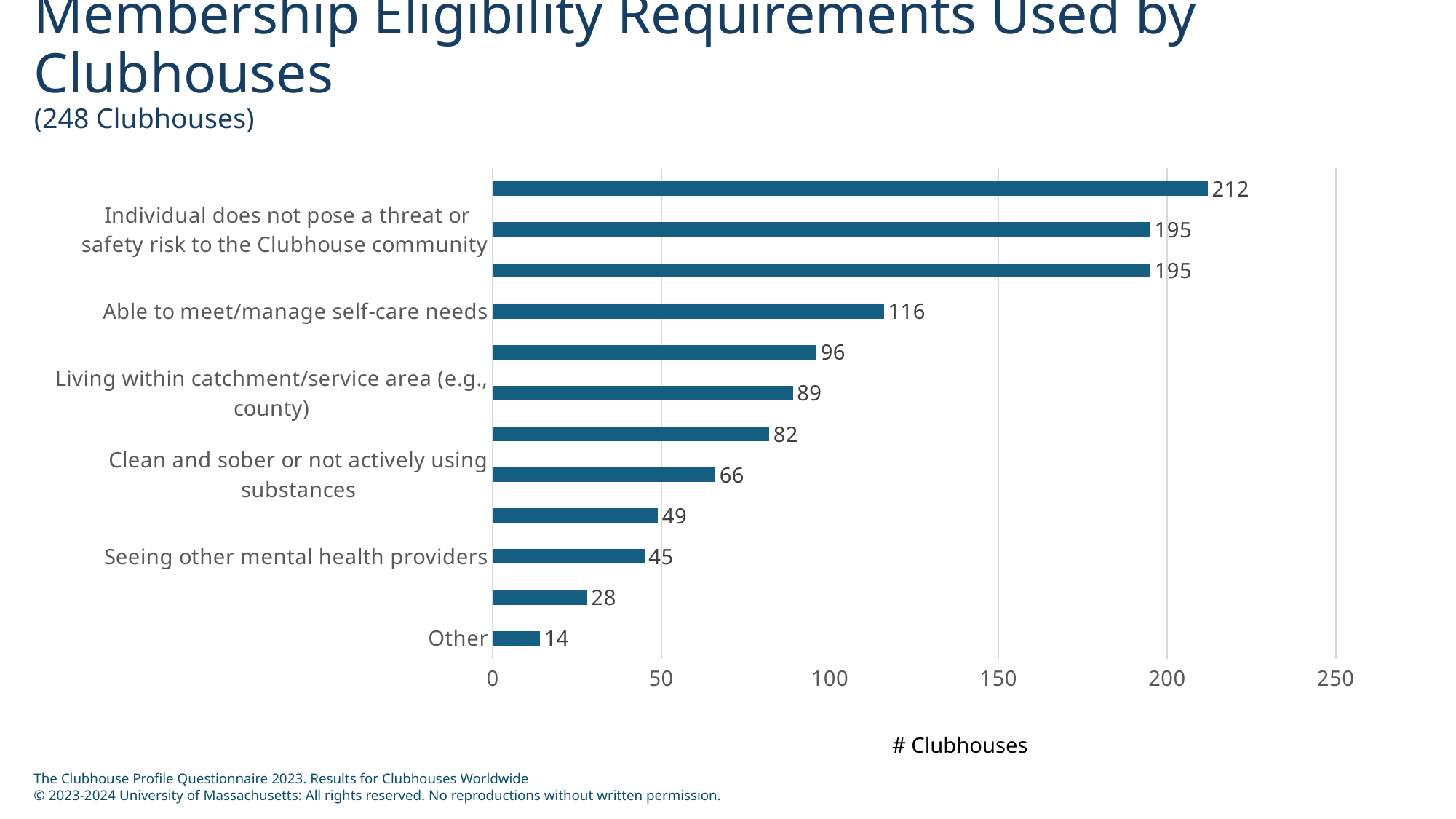
How many bars are plotted on the chart? 12 What is the difference between 'Able to meet/manage self-care needs' and 'Clean and sober or not actively using substances'? 50 What is the label of the horizontal axis? # Clubhouses How many clubhouses require members to be 'Clean and sober or not actively using substances'? 66 Which is larger: 'Living within catchment/service area (e.g., county)' or 'Seeing other mental health providers'? Living within catchment/service area (e.g., county) What kind of chart is shown on the slide? Bar chart What is the value for 'Seeing other mental health providers'? 45 Which labelled category has the lowest value? Other What is the value for 'Living within catchment/service area (e.g., county)'? 89 What is the highest value shown on the chart? 212 What is the value for 'Individual does not pose a threat or safety risk to the Clubhouse community'? 195 How many clubhouses use 'Able to meet/manage self-care needs' as a membership eligibility requirement? 116